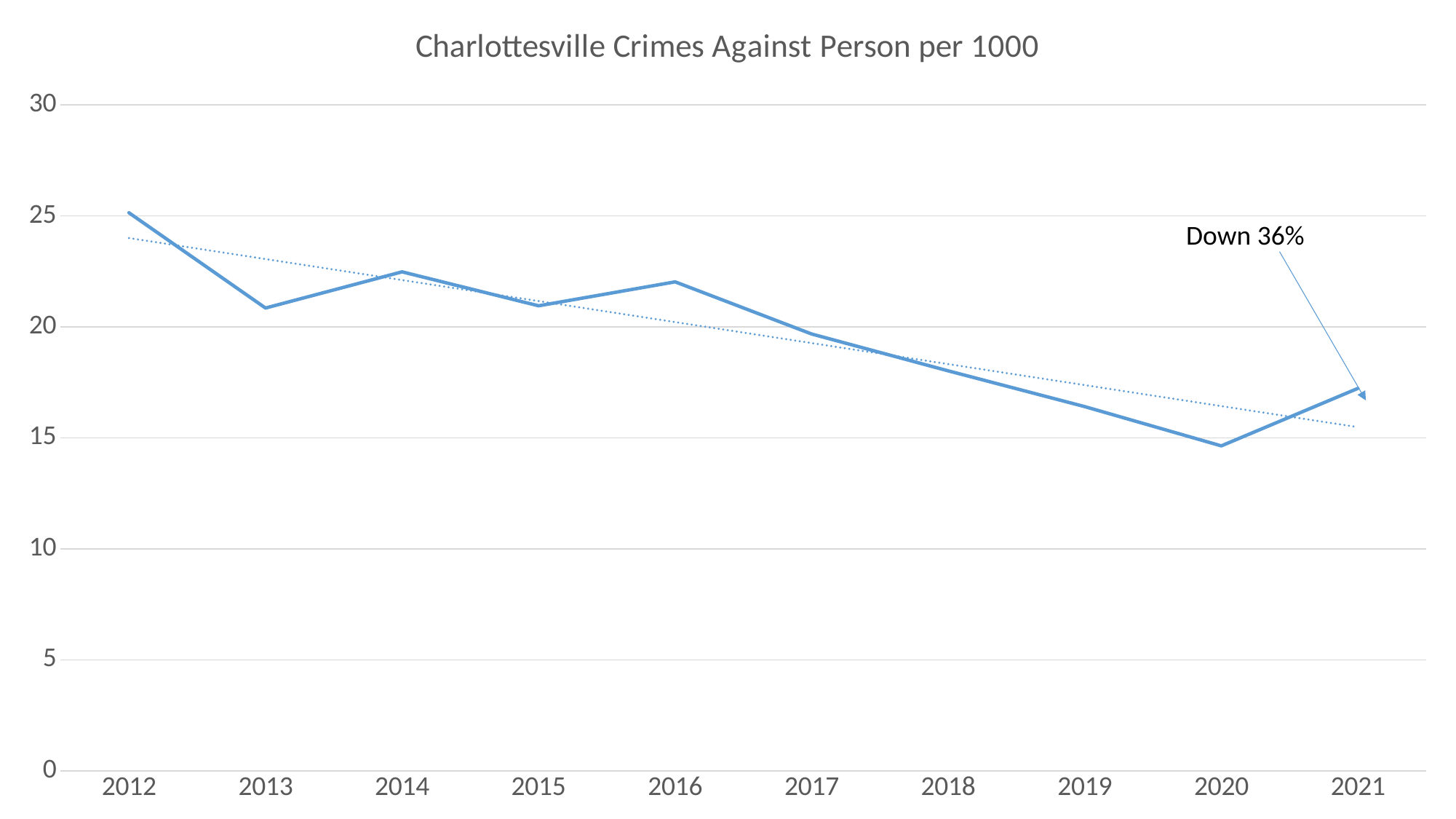
Do the values generally rise or fall from 2012 to 2021? fall Which year has the lowest value? 2020 What does the annotation pointing to the 2021 data point say? Down 36% Which year has the highest value? 2012 Which is larger, the value for 2012 or the value for 2021? 2012 Is the value for 2020 greater or less than 15? less Is the value for 2019 greater or less than 20? less How many years are plotted along the x axis? 10 Is the value for 2016 greater or less than 20? greater What is the title of the chart? Charlottesville Crimes Against Person per 1000 What kind of chart is shown on the slide? line chart